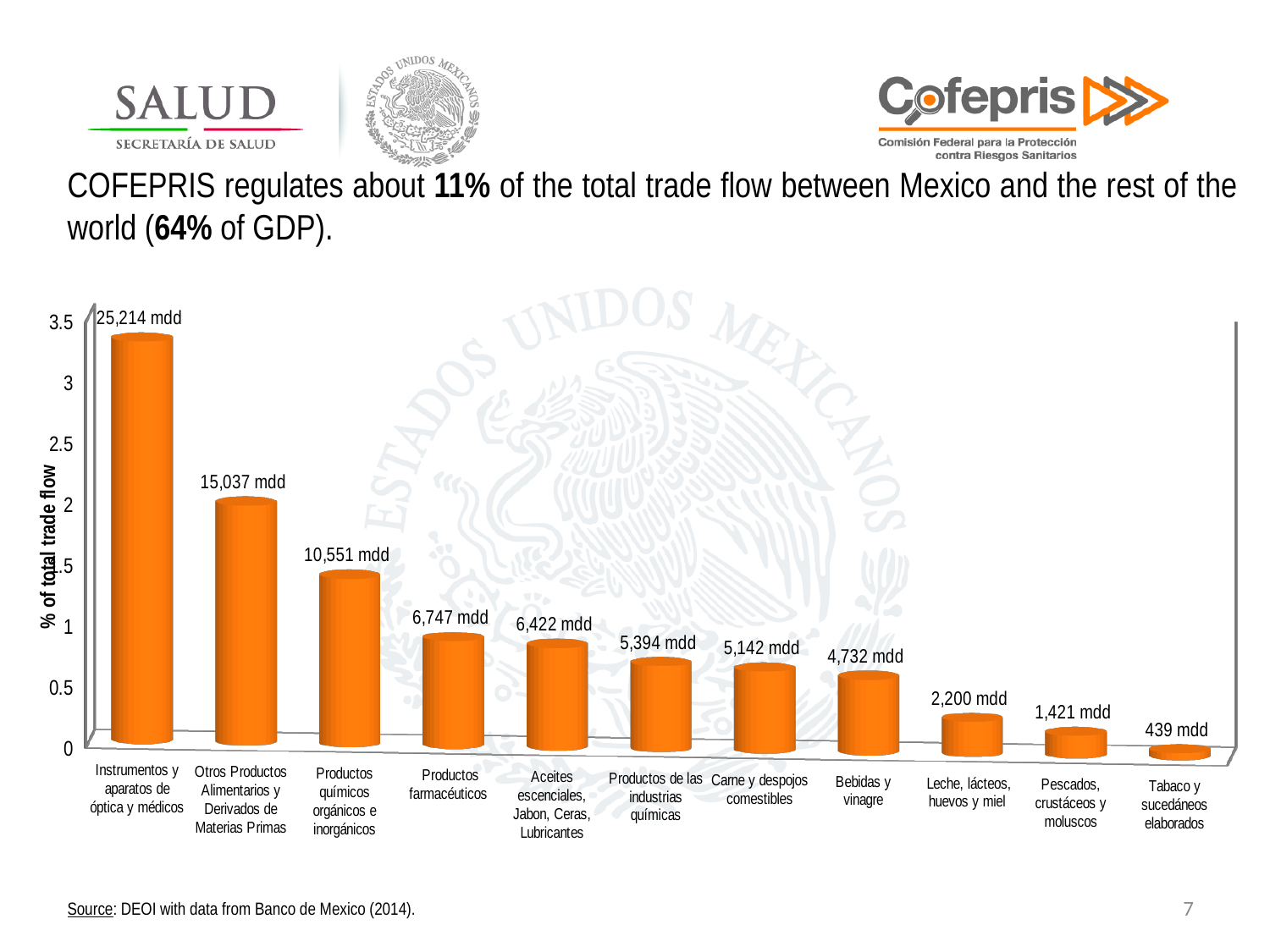
What is the value labelled for Productos farmacéuticos? 6,747 mdd Do the values rise or fall moving from left to right along the x axis? Fall Which category has the lowest value in the chart? Tabaco y sucedáneos elaborados What is the value labelled for Carne y despojos comestibles? 5,142 mdd What is the label of the vertical axis of the chart? % of total trade flow How many categories are plotted in the chart? 11 Which is larger, the value for Bebidas y vinagre or the value for Pescados, crustáceos y moluscos? Bebidas y vinagre Is the value for Instrumentos y aparatos de óptica y médicos on the % of total trade flow axis greater or less than 3? greater Which category has the highest value in the chart? Instrumentos y aparatos de óptica y médicos What is the difference between the labelled values for Instrumentos y aparatos de óptica y médicos and Otros Productos Alimentarios y Derivados de Materias Primas? 10,177 mdd What kind of chart is shown on the slide? Bar chart What is the value labelled for Leche, lácteos, huevos y miel? 2,200 mdd